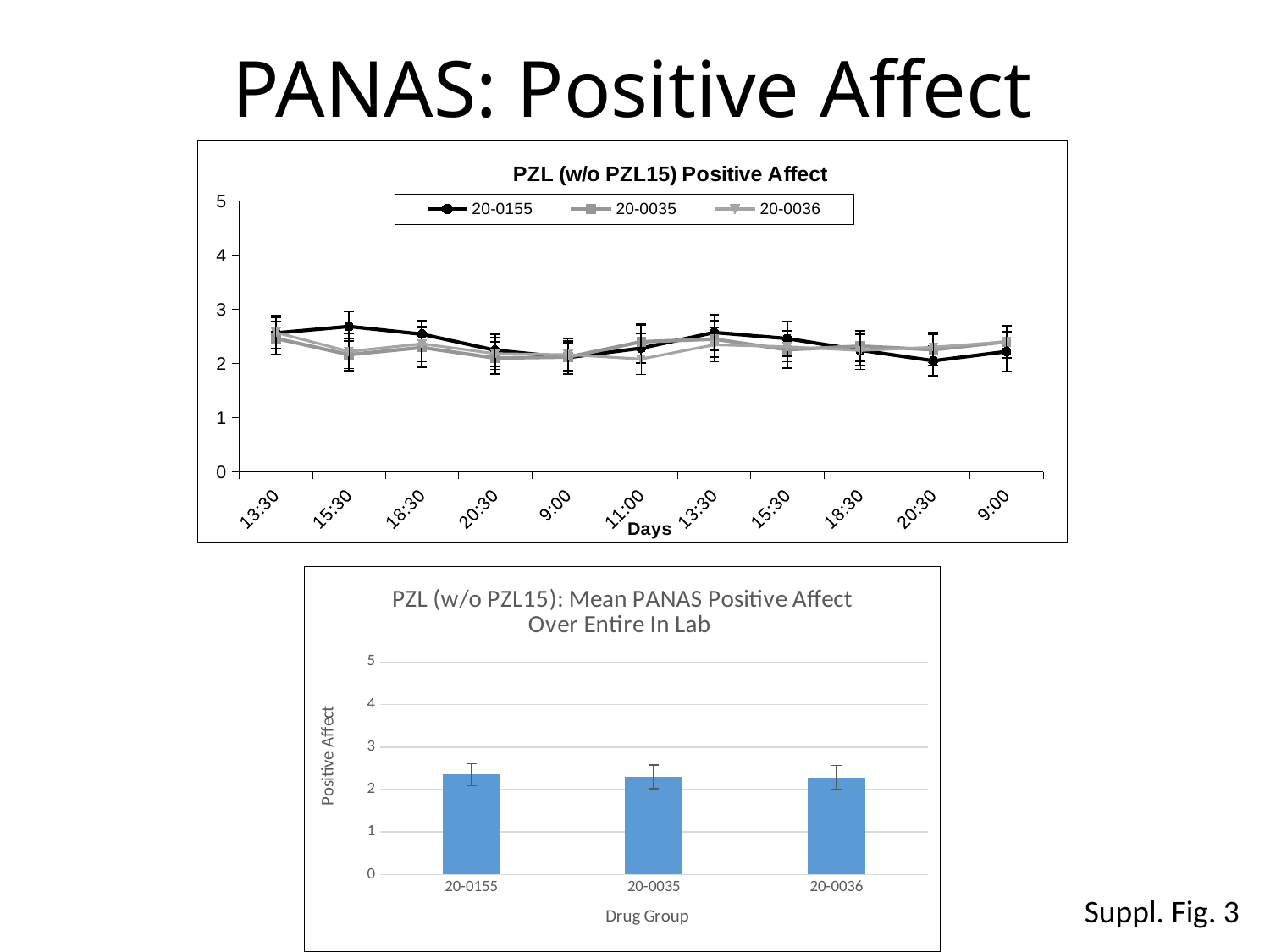
In the top line chart, is the value for 20-0155 at the first 15:30 time point greater or less than 3? less What is the x-axis title of the bottom bar chart? Drug Group In the top line chart, how many series does the legend list? 3 In the bottom bar chart, is the value for 20-0155 greater or less than 2? greater In the bottom bar chart, how many drug groups are shown? 3 In the top line chart, how many time points are plotted along the x axis? 11 What kind of chart is the top chart titled "PZL (w/o PZL15) Positive Affect"? line chart In the top line chart, which series is drawn in black? 20-0155 In the bottom bar chart, is the value for 20-0036 greater or less than 2? greater What kind of chart is the bottom chart titled "PZL (w/o PZL15): Mean PANAS Positive Affect Over Entire In Lab"? bar chart